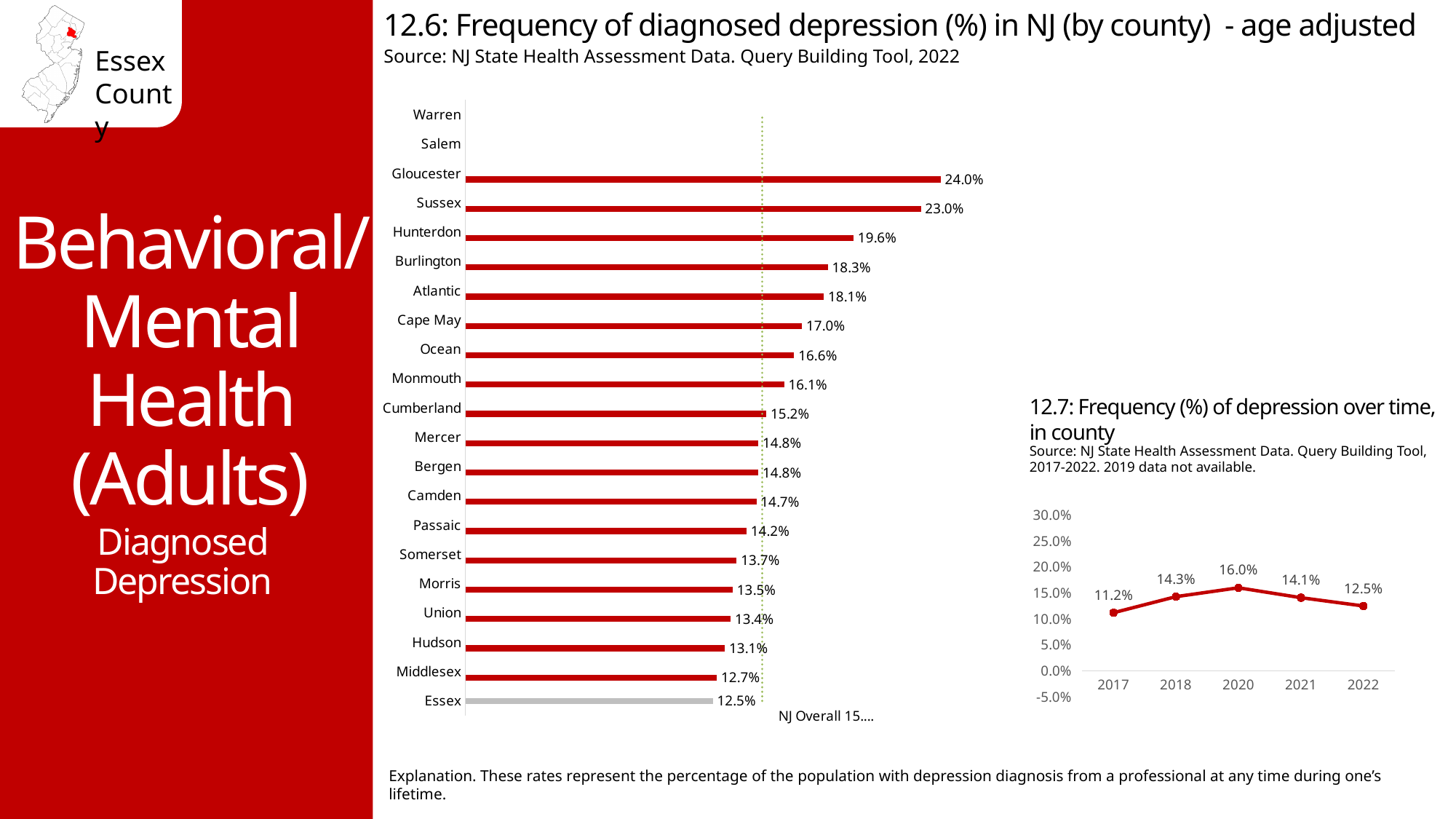
In chart 12.7, is the value for 2018 greater or less than 10.0%? greater What kind of chart is chart 12.6? Bar chart In chart 12.6, which county has the highest frequency of diagnosed depression? Gloucester In chart 12.6, what is the difference between the values for Sussex and Hunterdon? 3.4% In chart 12.7, what is the difference between the 2020 and 2022 values? 3.5% In chart 12.6, which has a higher value, Burlington or Cape May? Burlington In chart 12.7, how many data points are plotted? 5 In chart 12.7, which year has the lowest frequency of depression? 2017 In chart 12.6, which county with a plotted bar has the lowest frequency of diagnosed depression? Essex In chart 12.7, what is the frequency of depression in 2020? 16.0% In chart 12.6, what is the value shown for Essex? 12.5% In chart 12.6, what is the frequency of diagnosed depression for Gloucester? 24.0%